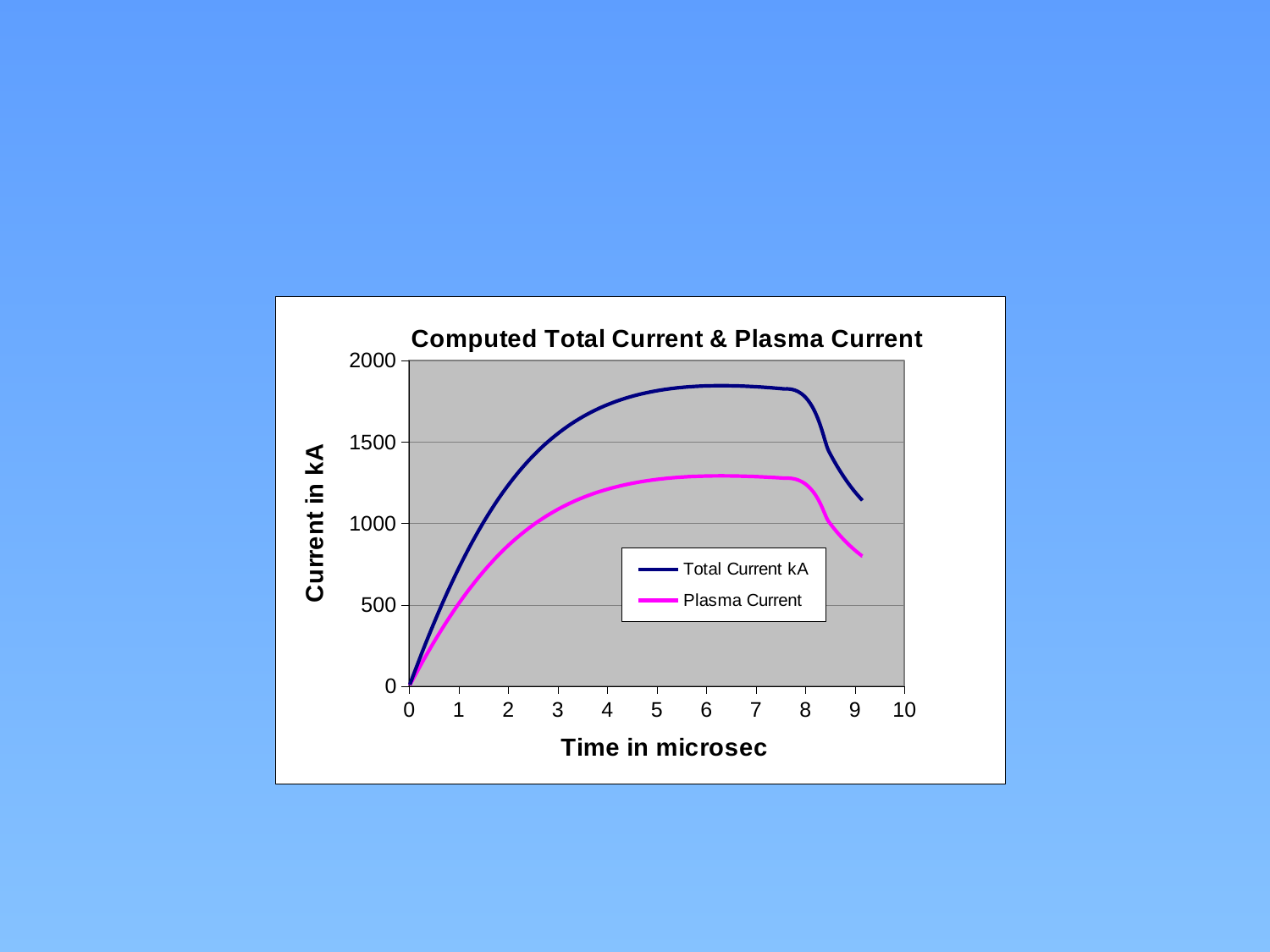
Does the Plasma Current series rise or fall between 8 and 9 microseconds? fall Is the Plasma Current value at 9 microseconds greater or less than 1000? less What is the title of the chart? Computed Total Current & Plasma Current What is the label of the y axis? Current in kA Is the Total Current kA value at 1 microsecond greater or less than 1000? less Is the Plasma Current value at 4 microseconds greater or less than 1000? greater What type of chart is shown on the slide? line chart Which series is higher at 6 microseconds, Total Current kA or Plasma Current? Total Current kA Does the Total Current kA series rise or fall between 0 and 5 microseconds? rise How many series does the legend list? 2